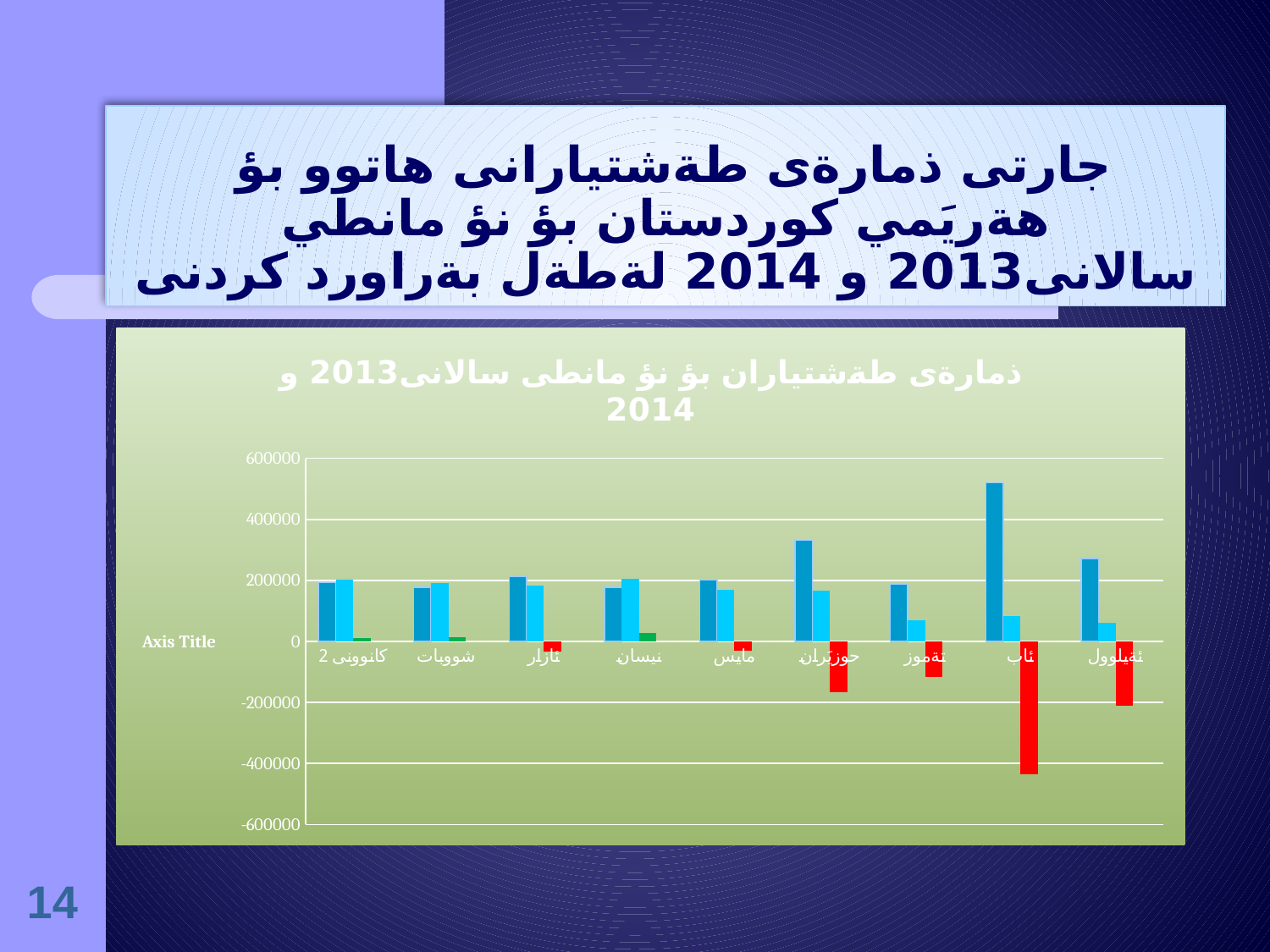
Is the red bar for ئاب greater or less than -200000? less Is the light blue bar for تەموز greater or less than 100000? less Which dark blue bar is larger, ئاب or حوزەيران? ئاب What kind of chart is shown on the slide? bar chart How many categories (months) are shown on the x axis of the chart? 9 Is the red bar for ئەيلوول greater or less than -100000? less What is the title of the vertical axis of the chart? Axis Title Which category has the tallest dark blue bar? ئاب For ئەيلوول, which bar is larger, the dark blue one or the light blue one? dark blue How many categories have a red (negative) bar? 6